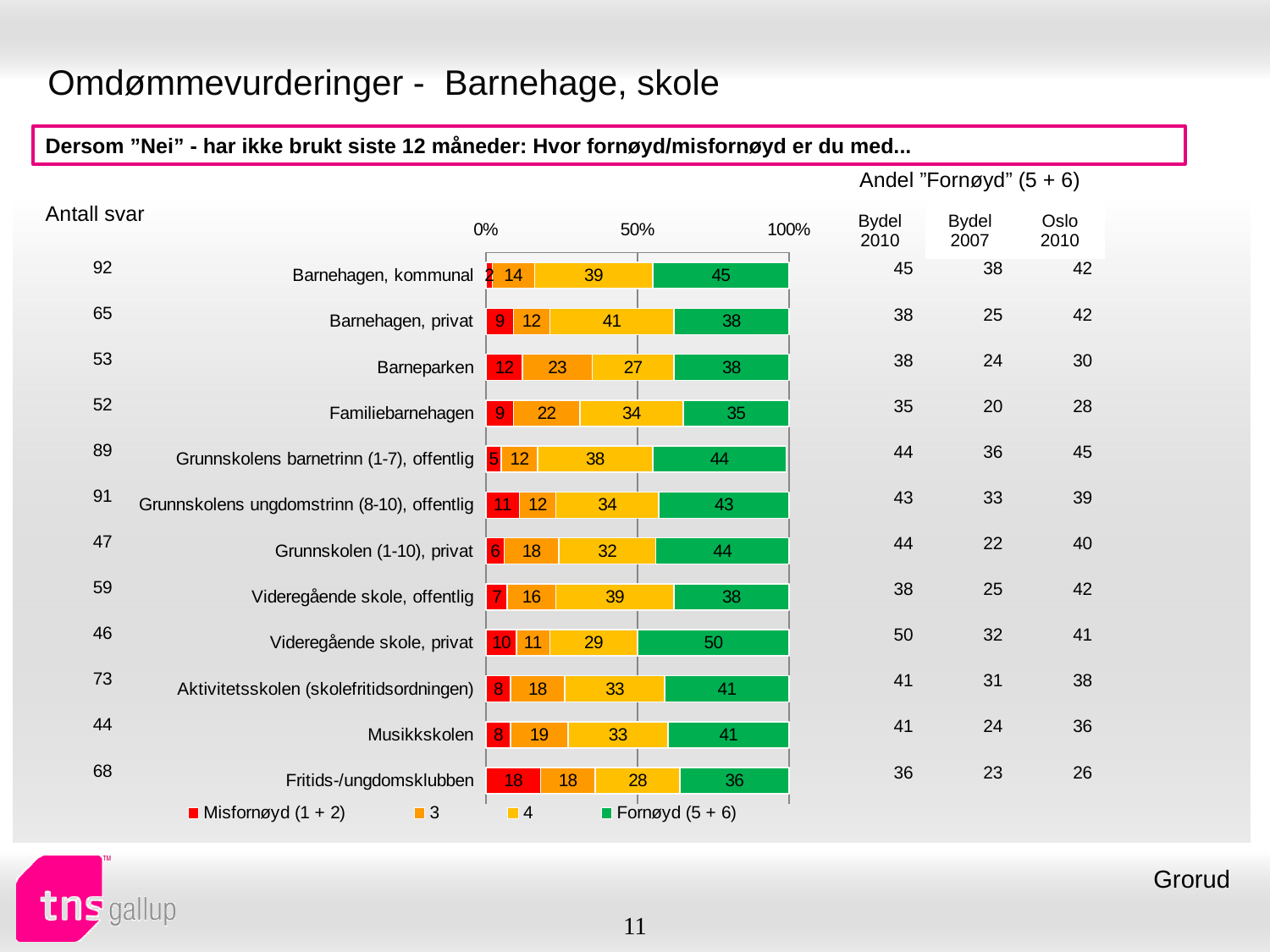
How many categories are plotted in the chart? 12 What is the Misfornøyd (1 + 2) value for Fritids-/ungdomsklubben? 18 Which has a larger Fornøyd (5 + 6) value: Barnehagen, kommunal or Barnehagen, privat? Barnehagen, kommunal What is the value of series 3 for Barneparken? 23 Which category has the highest Fornøyd (5 + 6) value? Videregående skole, privat Which category has the lowest Misfornøyd (1 + 2) value? Barnehagen, kommunal What is the total of the stacked bar for Fritids-/ungdomsklubben? 100 What type of chart is shown on the slide? stacked bar chart Which category has the lowest Fornøyd (5 + 6) value? Familiebarnehagen What is the difference between the Fornøyd (5 + 6) values for Videregående skole, privat and Videregående skole, offentlig? 12 What is the Fornøyd (5 + 6) value for Barnehagen, kommunal? 45 How many series does the chart legend list? 4